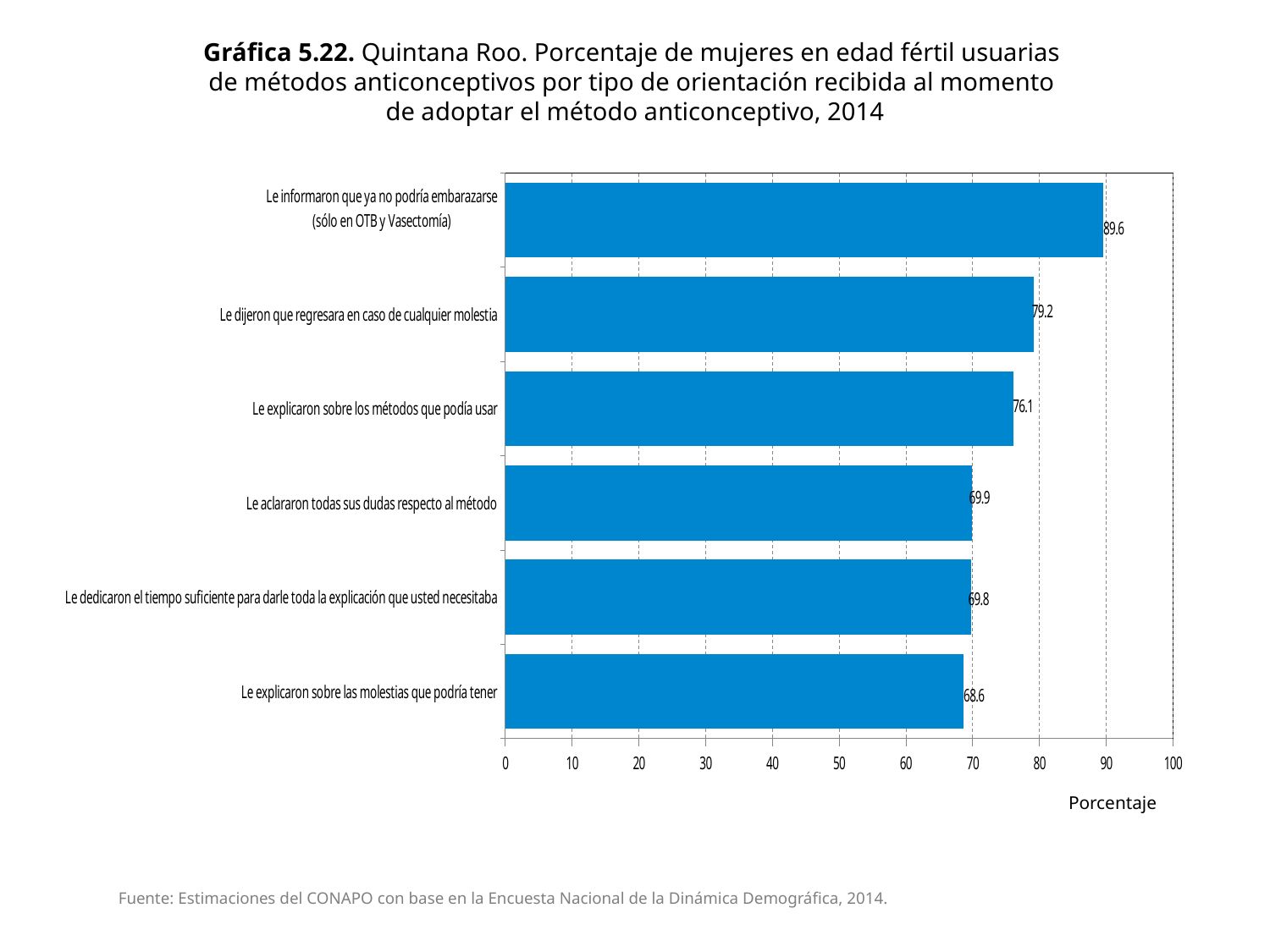
How many categories are shown in the chart? 6 What is the difference between the values for "Le informaron que ya no podría embarazarse (sólo en OTB y Vasectomía)" and "Le dijeron que regresara en caso de cualquier molestia"? 10.4 Which is larger: the value for "Le dijeron que regresara en caso de cualquier molestia" or for "Le explicaron sobre los métodos que podía usar"? Le dijeron que regresara en caso de cualquier molestia Which category has the highest value? Le informaron que ya no podría embarazarse (sólo en OTB y Vasectomía) What is the label of the horizontal axis? Porcentaje Which category has the lowest value? Le explicaron sobre las molestias que podría tener What is the value for "Le explicaron sobre los métodos que podía usar"? 76.1 What is the value for "Le informaron que ya no podría embarazarse (sólo en OTB y Vasectomía)"? 89.6 What kind of chart is shown on the slide? Bar chart Is the value for "Le aclararon todas sus dudas respecto al método" greater or less than 60? greater What is the difference between the values for "Le aclararon todas sus dudas respecto al método" and "Le explicaron sobre las molestias que podría tener"? 1.3 What is the value for "Le explicaron sobre las molestias que podría tener"? 68.6